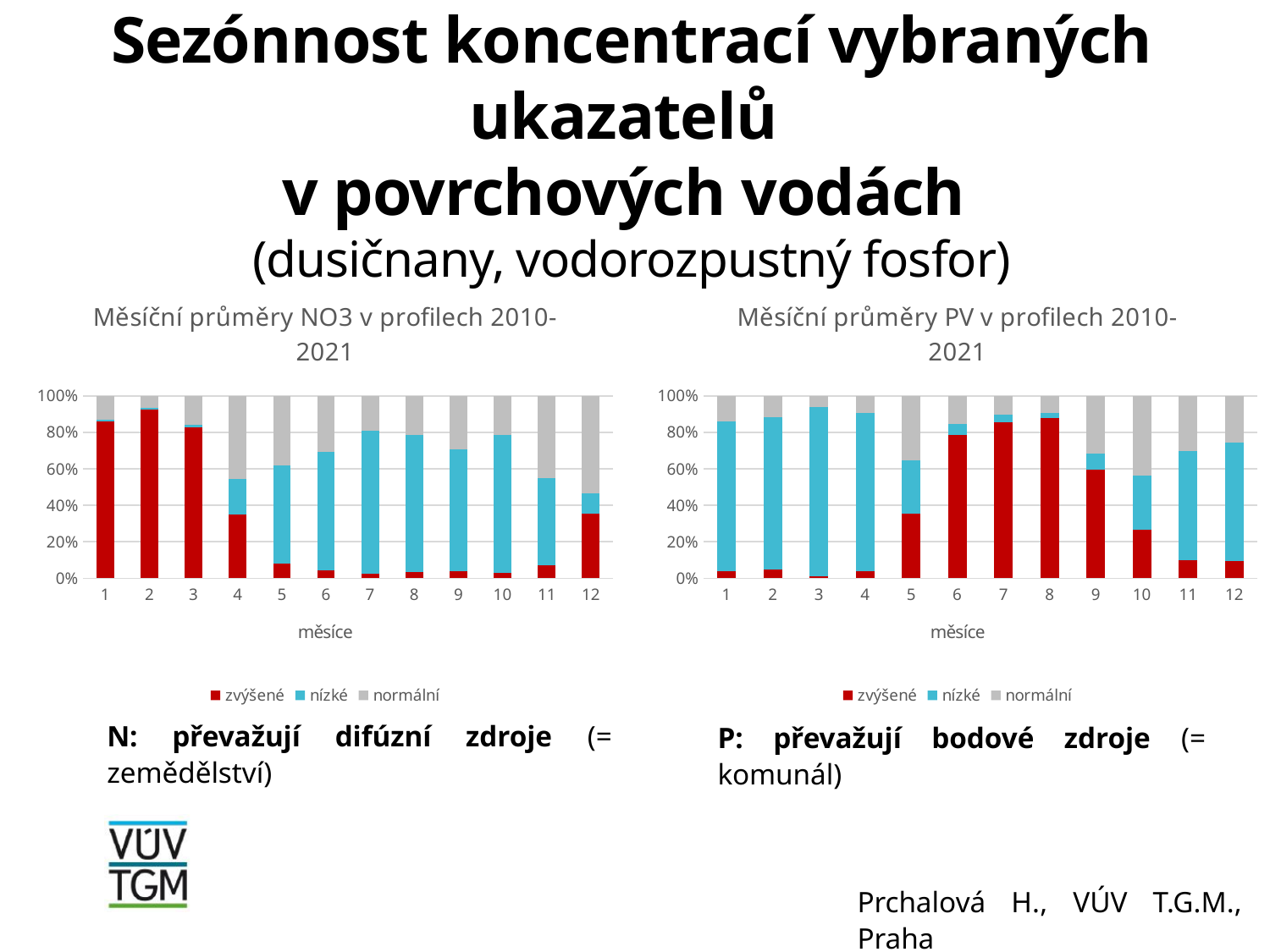
In the right chart, 'Měsíční průměry PV v profilech 2010-2021', which month has the largest 'nízké' (blue) share? 3 In the right chart, 'Měsíční průměry PV v profilech 2010-2021', is the 'zvýšené' share for month 6 greater or less than 60%? greater In the left chart, 'Měsíční průměry NO3 v profilech 2010-2021', is the 'zvýšené' share for month 4 greater or less than 40%? less How many months (categories) are shown on the x axis of the right chart, 'Měsíční průměry PV v profilech 2010-2021'? 12 In the right chart, 'Měsíční průměry PV v profilech 2010-2021', is the 'zvýšené' share for month 10 greater or less than 40%? less In the right chart, 'Měsíční průměry PV v profilech 2010-2021', does the 'zvýšené' share rise or fall from month 4 to month 8? rise In the left chart, 'Měsíční průměry NO3 v profilech 2010-2021', does the 'zvýšené' share rise or fall from month 3 to month 7? fall In the left chart, 'Měsíční průměry NO3 v profilech 2010-2021', which month has the largest 'zvýšené' (red) share? 2 How many series does the legend of the left chart, 'Měsíční průměry NO3 v profilech 2010-2021', list? 3 What are the three legend entries of the right chart, 'Měsíční průměry PV v profilech 2010-2021'? zvýšené, nízké, normální What kind of chart is the left chart, 'Měsíční průměry NO3 v profilech 2010-2021'? Stacked bar chart